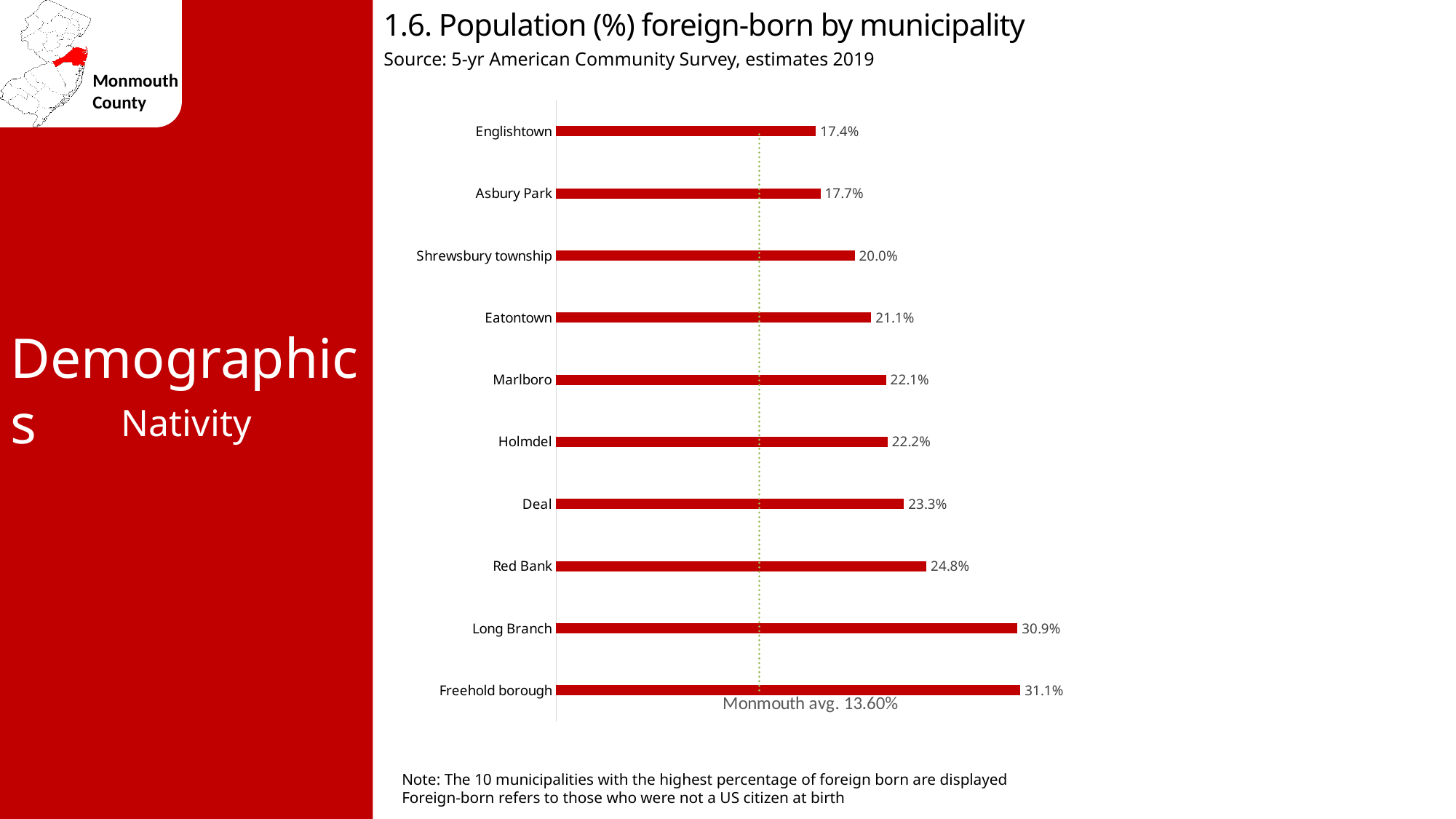
Which municipality has the lowest percentage of foreign-born population on the chart? Englishtown What is the title of the chart? 1.6. Population (%) foreign-born by municipality Which municipality has the highest percentage of foreign-born population? Freehold borough How many municipalities are shown on the chart? 10 What kind of chart is shown on the slide? Bar chart What is the difference in foreign-born percentage between Freehold borough and Englishtown? 13.7% What is the difference in foreign-born percentage between Red Bank and Deal? 1.5% What is the percentage of foreign-born population in Englishtown? 17.4% What Monmouth County average value is marked by the dotted line on the chart? 13.60% Which has a higher foreign-born percentage, Shrewsbury township or Eatontown? Eatontown What is the percentage of foreign-born population in Red Bank? 24.8% What is the percentage of foreign-born population in Long Branch? 30.9%